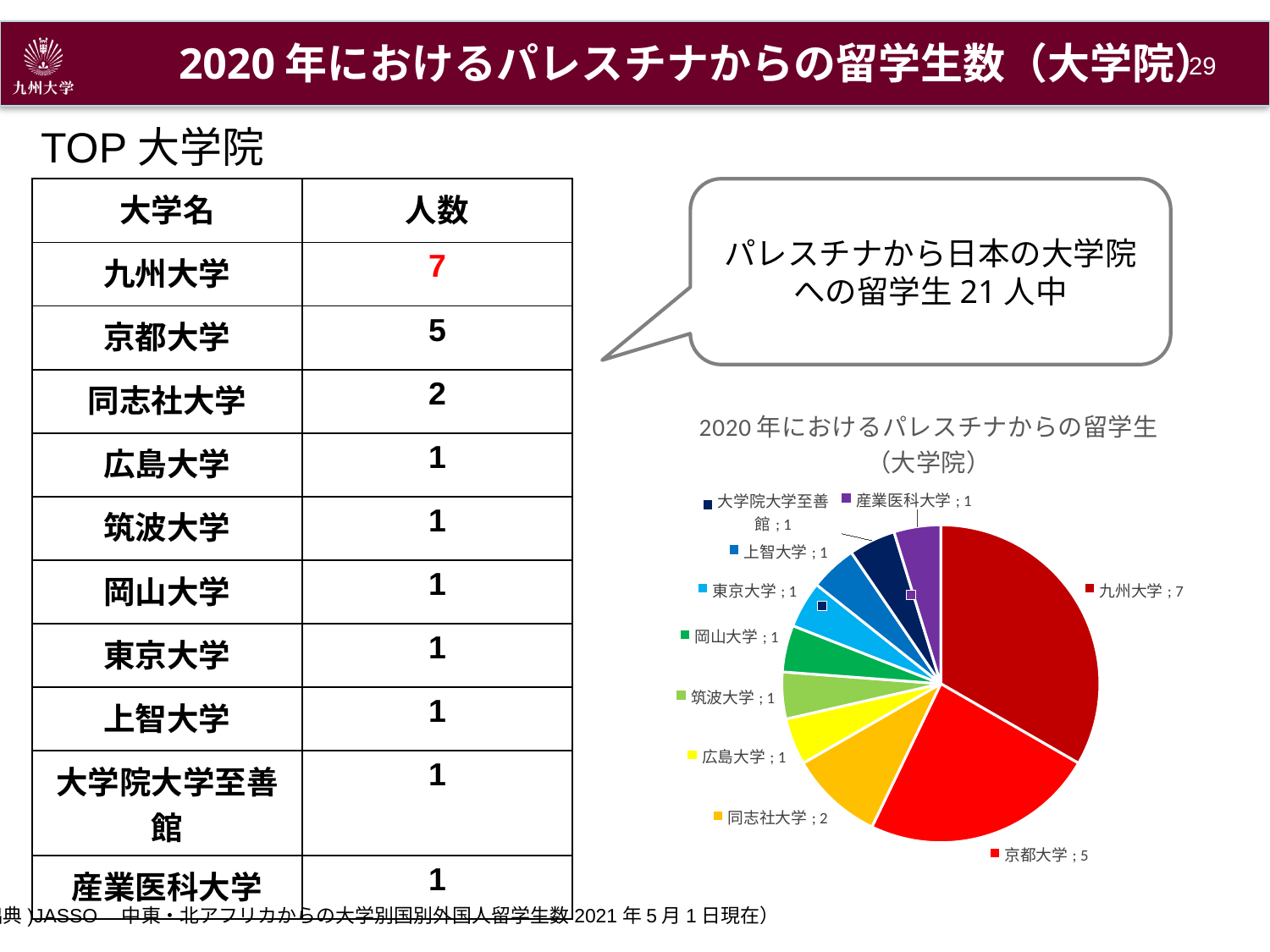
What is the difference between the values for 九州大学 and 京都大学 in the pie chart? 2 Which is larger in the pie chart, the value for 京都大学 or the value for 同志社大学? 京都大学 How many universities in the pie chart have a value of 1? 7 What is the value for 産業医科大学 in the pie chart? 1 What is the value for 同志社大学 in the pie chart? 2 What is the value for 京都大学 in the pie chart? 5 What is the title of the pie chart? 2020年におけるパレスチナからの留学生（大学院） What kind of chart is shown on the slide? pie chart How many slices does the pie chart have? 10 What is the value for 九州大学 in the pie chart? 7 What is the total of all the slices in the pie chart? 21 Which university has the largest slice in the pie chart? 九州大学